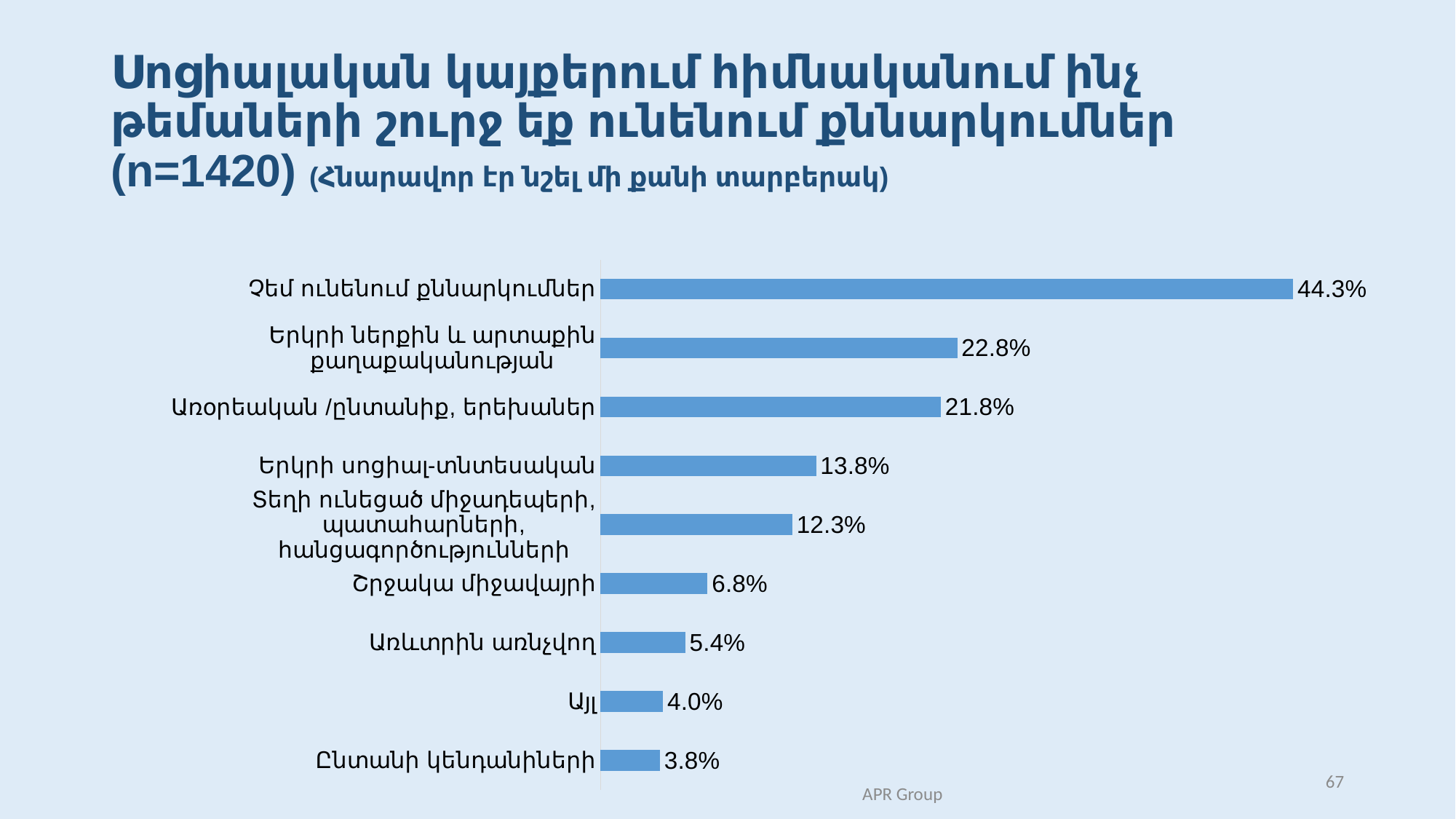
What kind of chart is shown on the slide? Bar chart What is the value for "Այլ"? 4.0% What is the value for "Երկրի սոցիալ-տնտեսական"? 13.8% How many categories are shown in the chart? 9 What sample size (n) is stated in the slide title? n=1420 Which is larger: the value for "Առևտրին առնչվող" or the value for "Շրջակա միջավայրի"? Շրջակա միջավայրի Which category has the lowest value? Ընտանի կենդանիների What is the value for "Շրջակա միջավայրի"? 6.8% What is the value for "Չեմ ունենում քննարկումներ"? 44.3% What is the difference between the values for "Երկրի ներքին և արտաքին քաղաքականության" and "Առօրեական /ընտանիք, երեխաներ"? 1.0% Which category has the highest value? Չեմ ունենում քննարկումներ What is the difference between the values for "Չեմ ունենում քննարկումներ" and "Երկրի սոցիալ-տնտեսական"? 30.5%